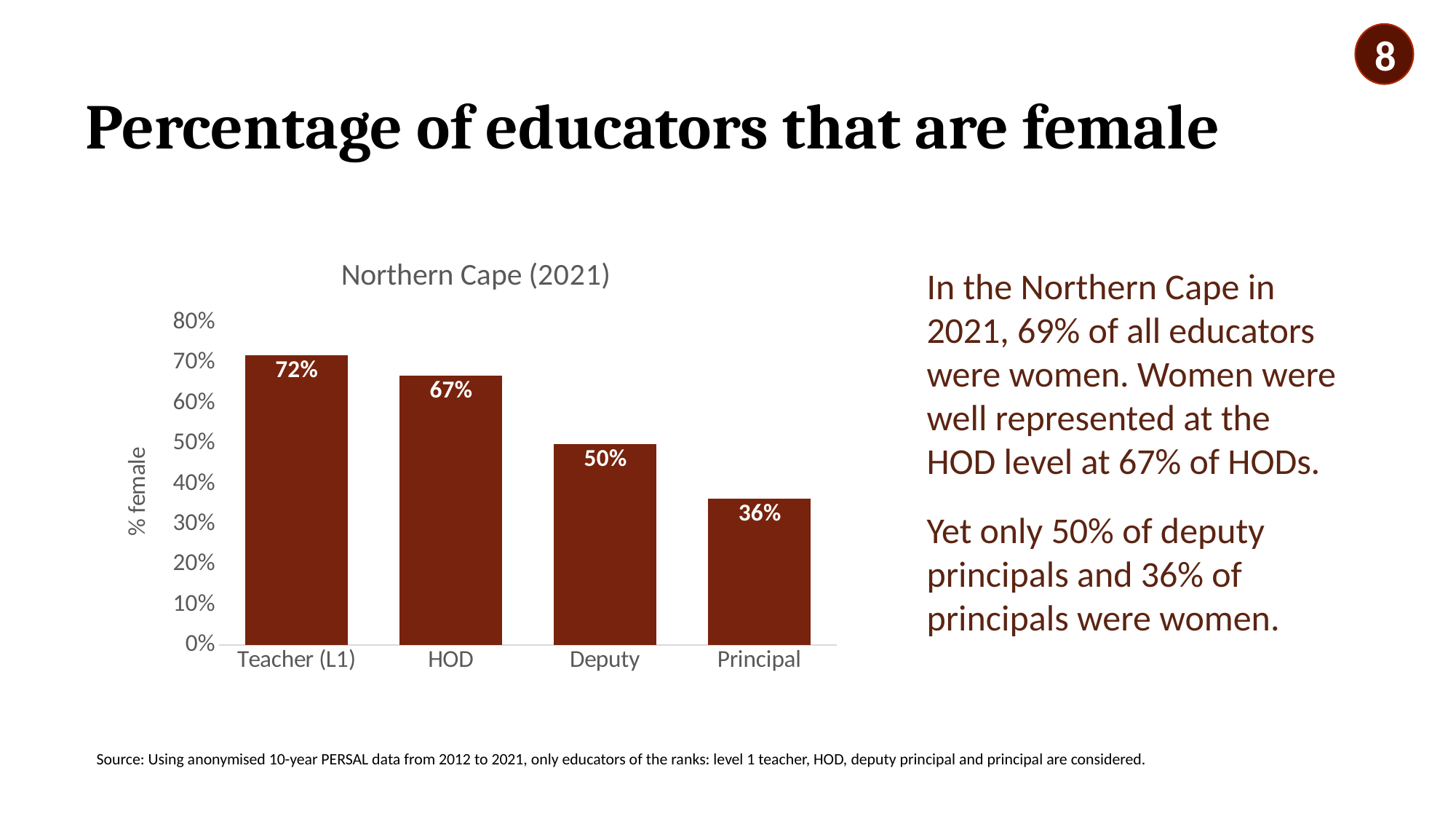
How many categories are shown on the x axis of the chart? 4 Which is larger, the value for HOD or the value for Deputy? HOD Which category has the lowest percentage of female educators? Principal Which category has the highest percentage of female educators? Teacher (L1) Do the values rise or fall from Teacher (L1) to Principal along the x axis? Fall What is the difference between the values for HOD and Deputy? 17% What is the value shown for Deputy? 50% What is the value shown for HOD? 67% What percentage of Teacher (L1) educators are female? 72% What kind of chart is shown on the slide? Bar chart What is the difference between the values for Teacher (L1) and Principal? 36% What is the value shown for Principal? 36%